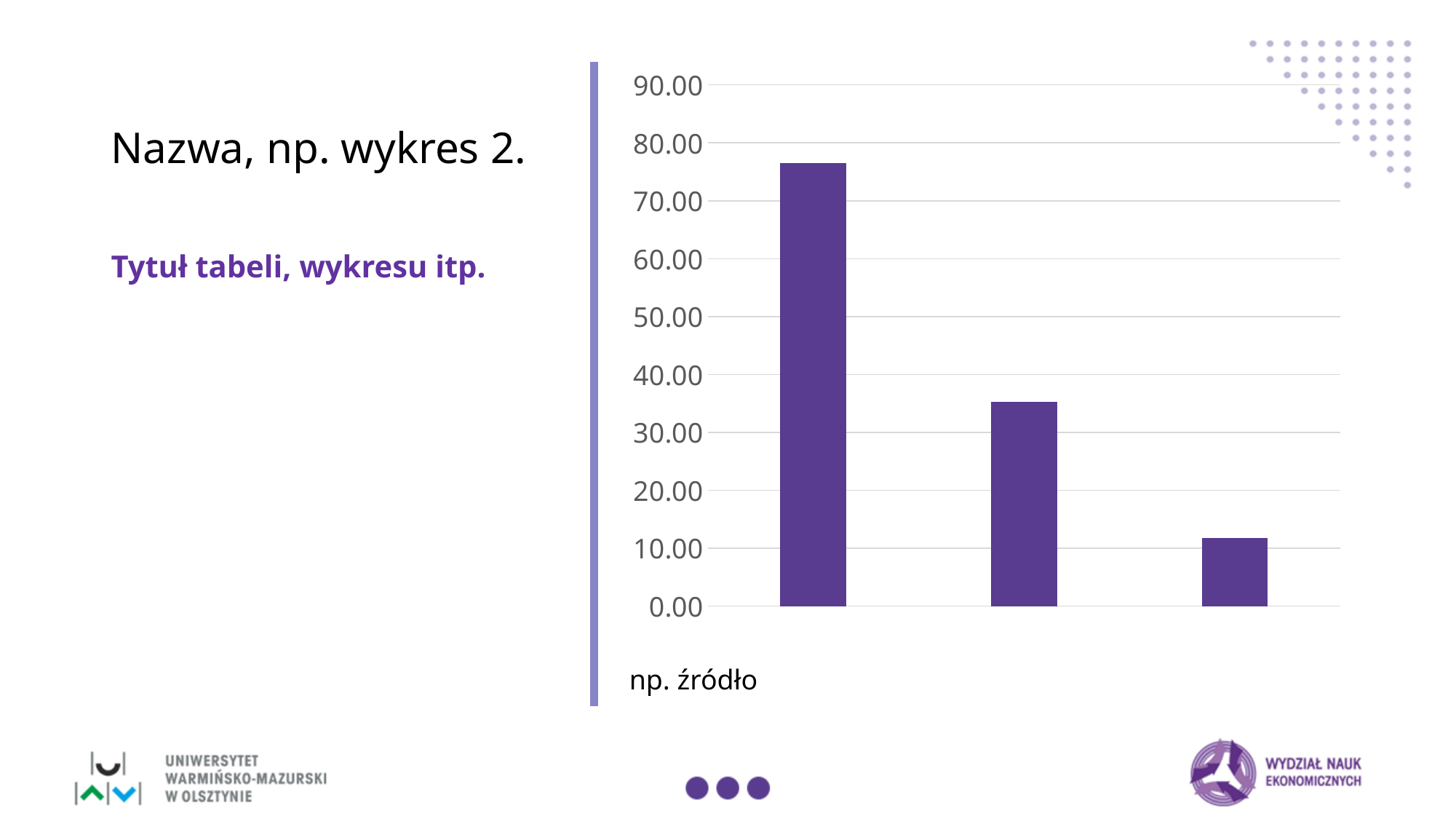
How many bars does the chart show? 3 Is the value of the middle bar greater or less than 30.00? greater Do the bar values rise or fall from left to right? fall Is the value of the right bar greater or less than 20.00? less What kind of chart is shown on the slide? bar chart Is the value of the middle bar greater or less than 40.00? less Which bar is the tallest: the left, middle or right one? left Which bar is the shortest: the left, middle or right one? right What is the highest value shown on the vertical axis? 90.00